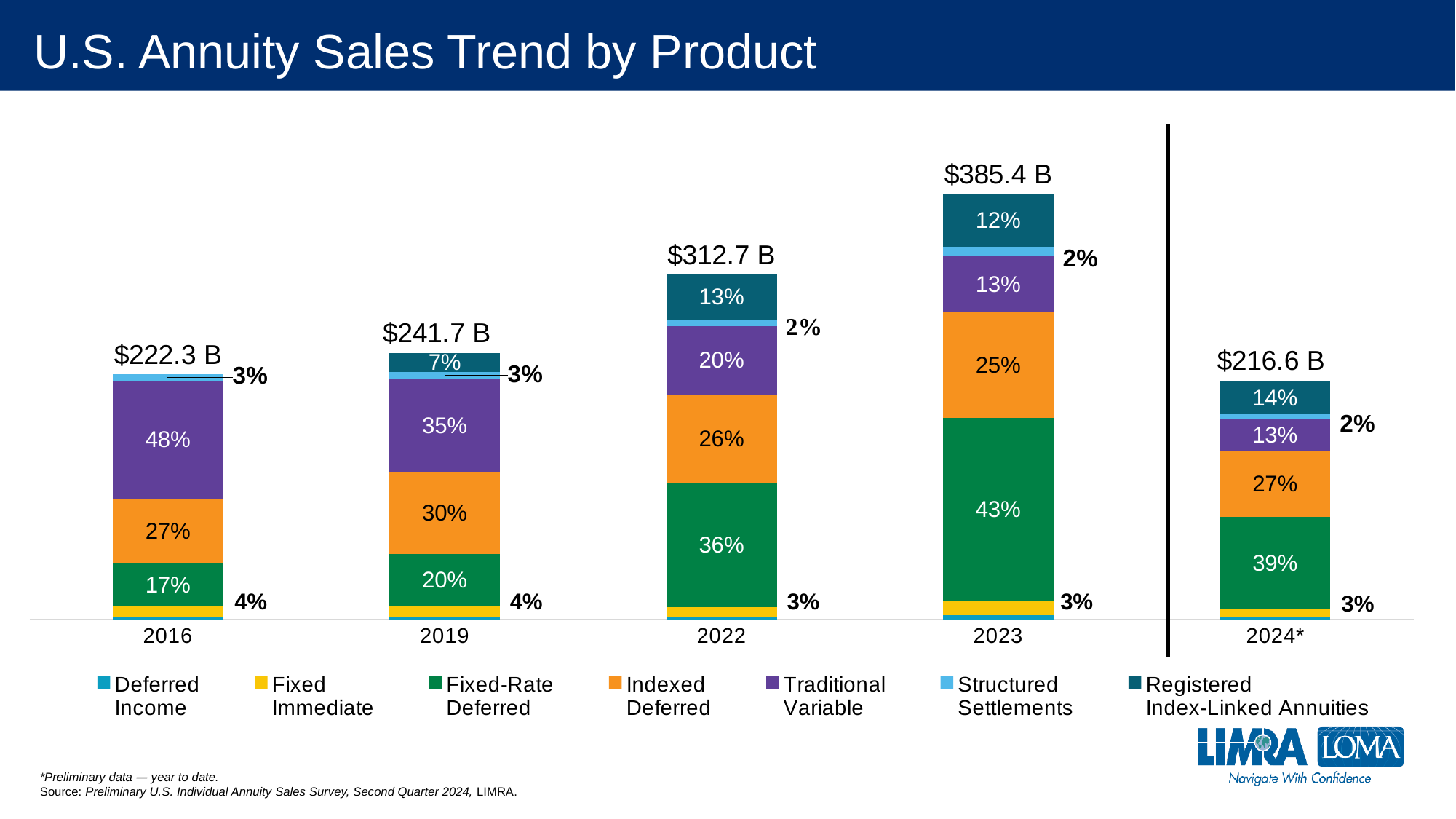
What share of sales did Fixed-Rate Deferred annuities make up in 2023? 43% How does the Traditional Variable share change from 2016 to 2024*? It falls What share of sales did Registered Index-Linked Annuities make up in 2019? 7% Which is larger, the total sales in 2019 or in 2024*? 2019 Which year has the highest total annuity sales? 2023 How many years are shown on the x axis? 5 What was the total U.S. annuity sales value shown for 2023? $385.4 B What is the difference between the total sales in 2023 and 2022? $72.7 B What share of sales did Traditional Variable annuities make up in 2016? 48% Which year has the lowest total annuity sales? 2024* How many product series does the legend list? 7 What was the total U.S. annuity sales value shown for 2016? $222.3 B